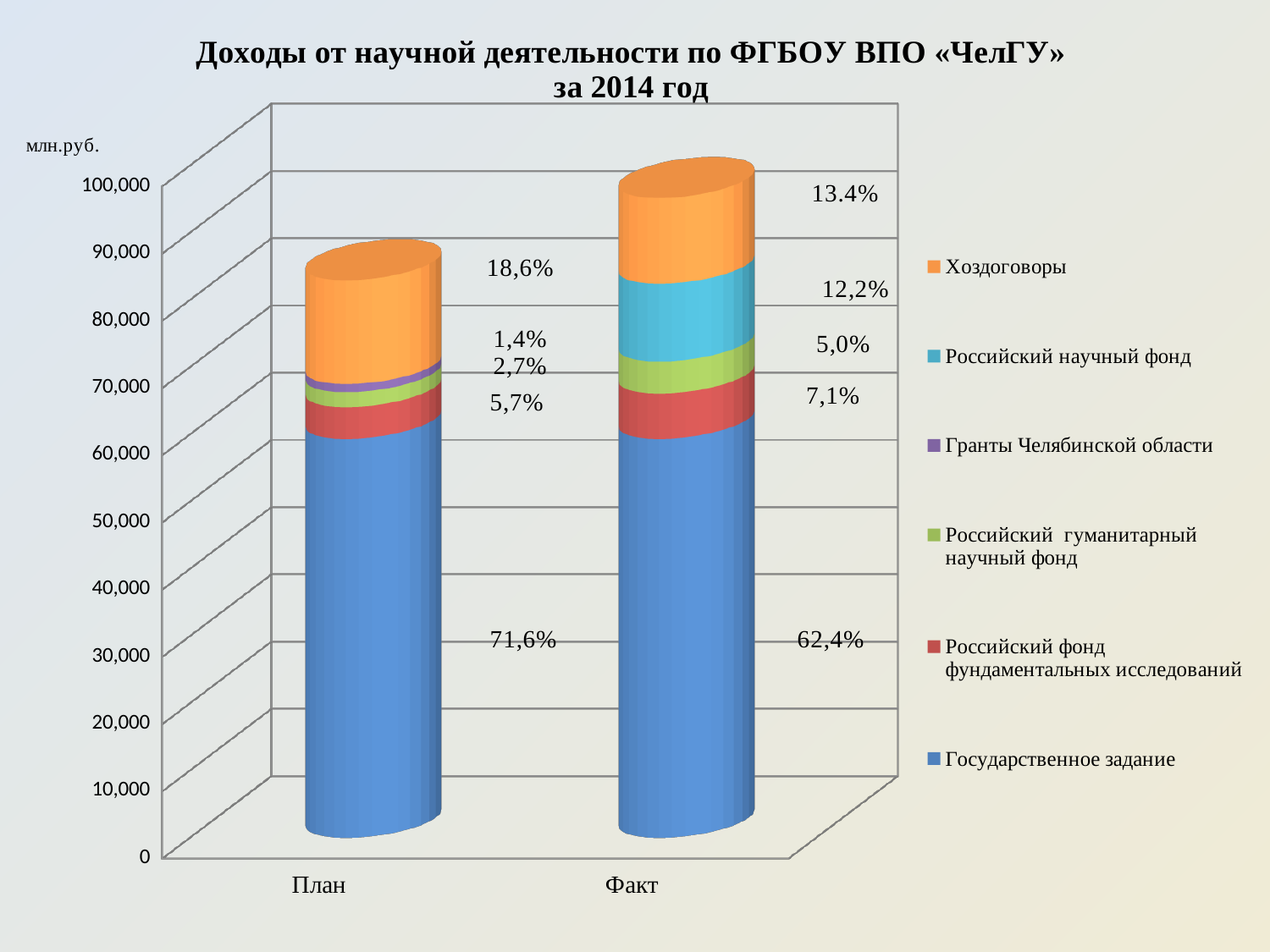
By how many percentage points does the share of Государственное задание in План exceed its share in Факт? 9,2 Which bar is taller in total, План or Факт? Факт What percentage label is shown for Государственное задание in the Факт bar? 62,4% What percentage label is shown for Хоздоговоры in the План bar? 18,6% What percentage label is shown for Российский фонд фундаментальных исследований in the План bar? 5,7% Which series has the largest share in the Факт bar? Государственное задание How many series does the legend list? 6 Is the total value of the Факт bar greater or less than 90,000? greater What kind of chart is shown on the slide? Stacked bar chart What percentage label is shown for Российский научный фонд in the Факт bar? 12,2% How many categories are shown on the x axis? 2 Which series has the smallest share in the План bar? Гранты Челябинской области